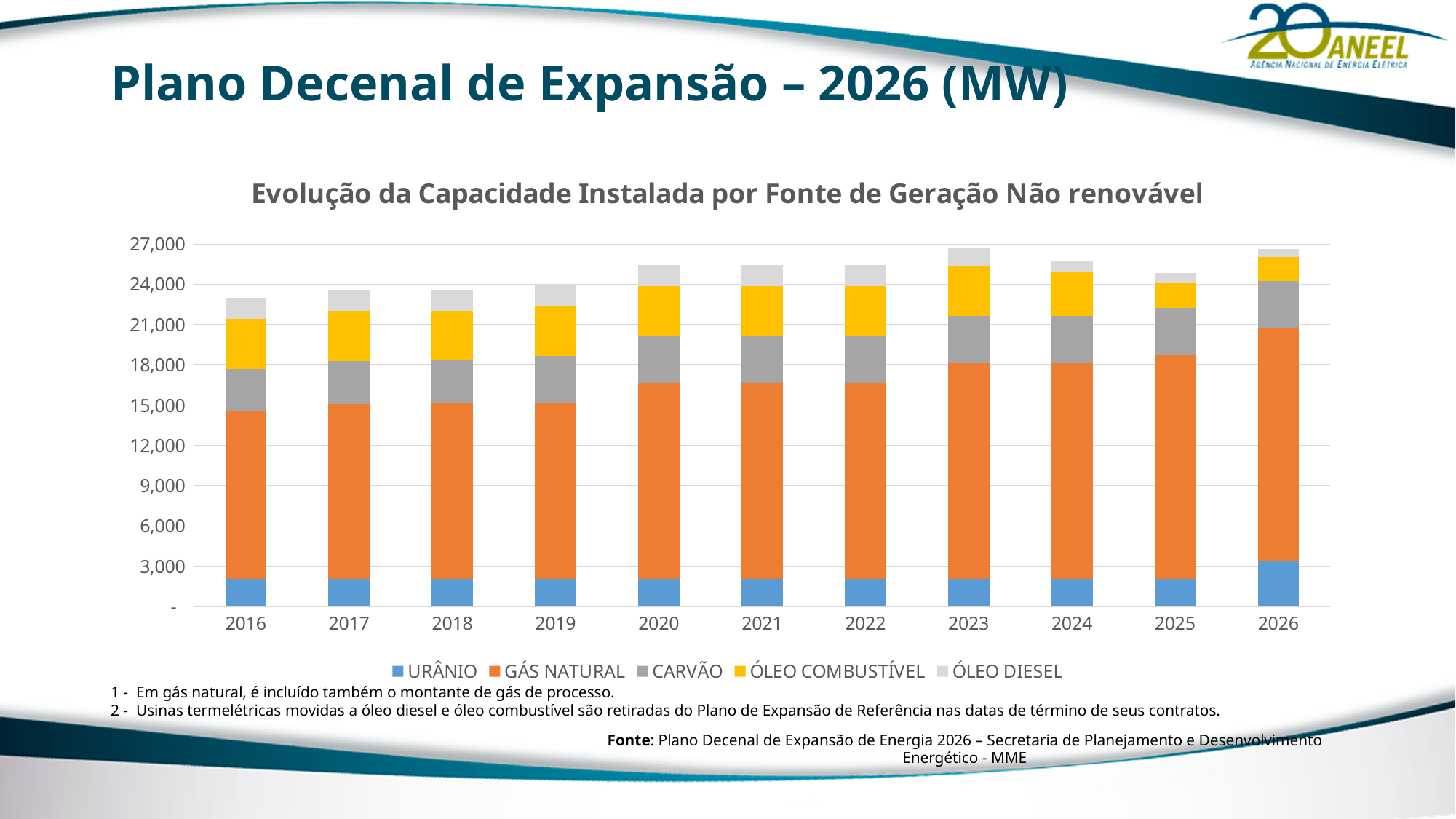
Is the URÂNIO value for 2026 greater or less than 3,000? greater Does the GÁS NATURAL value generally rise or fall from 2016 to 2026? rise Is the total stacked value for 2016 greater or less than 24,000? less How many series does the chart legend list? 5 Is the URÂNIO value for 2016 greater or less than 3,000? less How many years are shown on the x axis of the chart? 11 What kind of chart is shown on the slide? Stacked bar chart Which series is shown in orange in the chart? GÁS NATURAL Is the GÁS NATURAL value larger in 2016 or in 2026? 2026 Which year has the lowest total stacked value? 2016 What is the title of the chart? Evolução da Capacidade Instalada por Fonte de Geração Não renovável